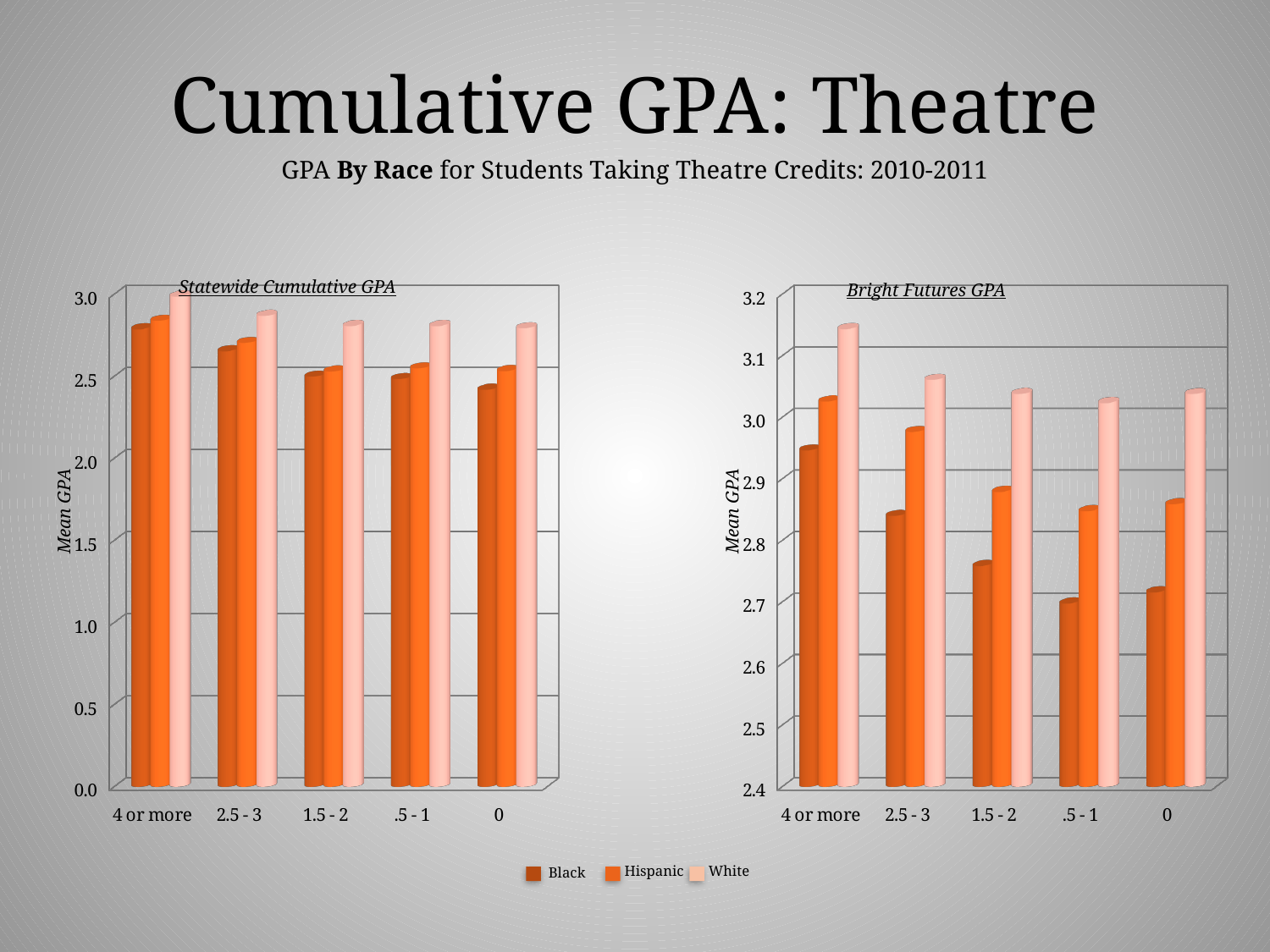
How many series does the legend list? 3 In the Bright Futures GPA chart, is the value for Black students in the "1.5 - 2" category greater or less than 2.8? less How many categories are shown on the x axis of the Bright Futures GPA chart? 5 What kind of chart is the Statewide Cumulative GPA chart? bar chart In the Statewide Cumulative GPA chart, is the value for Black students in the "4 or more" category greater or less than 2.5? greater In the Bright Futures GPA chart, which category has the highest value for Black students? 4 or more In the Bright Futures GPA chart, which is larger for Black students: the "4 or more" category or the "2.5 - 3" category? 4 or more In the Statewide Cumulative GPA chart, is the value for Black students in the "0" category greater or less than 2.5? less What is the label on the y axis of the Bright Futures GPA chart? Mean GPA In the Bright Futures GPA chart, which series has the tallest bar in the "4 or more" category? White